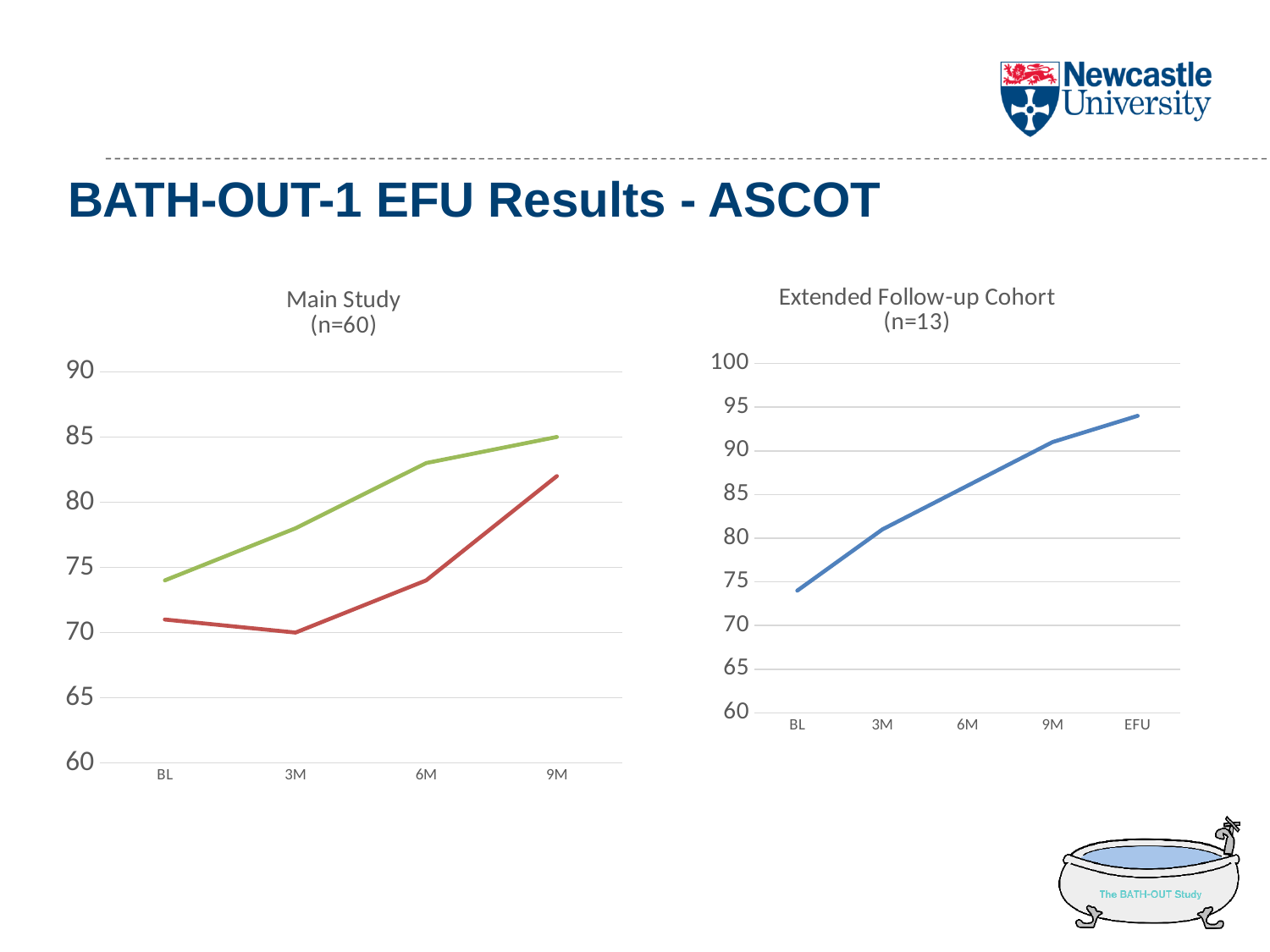
In the Main Study (n=60) chart, at 6M, which line has the higher value, the green line or the red line? the green line In the Extended Follow-up Cohort (n=13) chart, is the value at EFU greater or less than 90? greater In the Main Study (n=60) chart on the left, how many time points are shown on the x axis? 4 In the Main Study (n=60) chart, is the red line's value at 9M greater or less than 80? greater What kind of chart is the Main Study (n=60) chart on the left? line chart In the Extended Follow-up Cohort (n=13) chart, at which time point is the value highest? EFU In the Extended Follow-up Cohort (n=13) chart, do the values rise or fall from BL to EFU? rise In the Main Study (n=60) chart, is the green line's value at BL greater or less than 75? less What is the title of the chart on the right of the slide? Extended Follow-up Cohort (n=13) In the Extended Follow-up Cohort (n=13) chart, at which time point is the value lowest? BL In the Extended Follow-up Cohort (n=13) chart on the right, how many time points are plotted along the x axis? 5